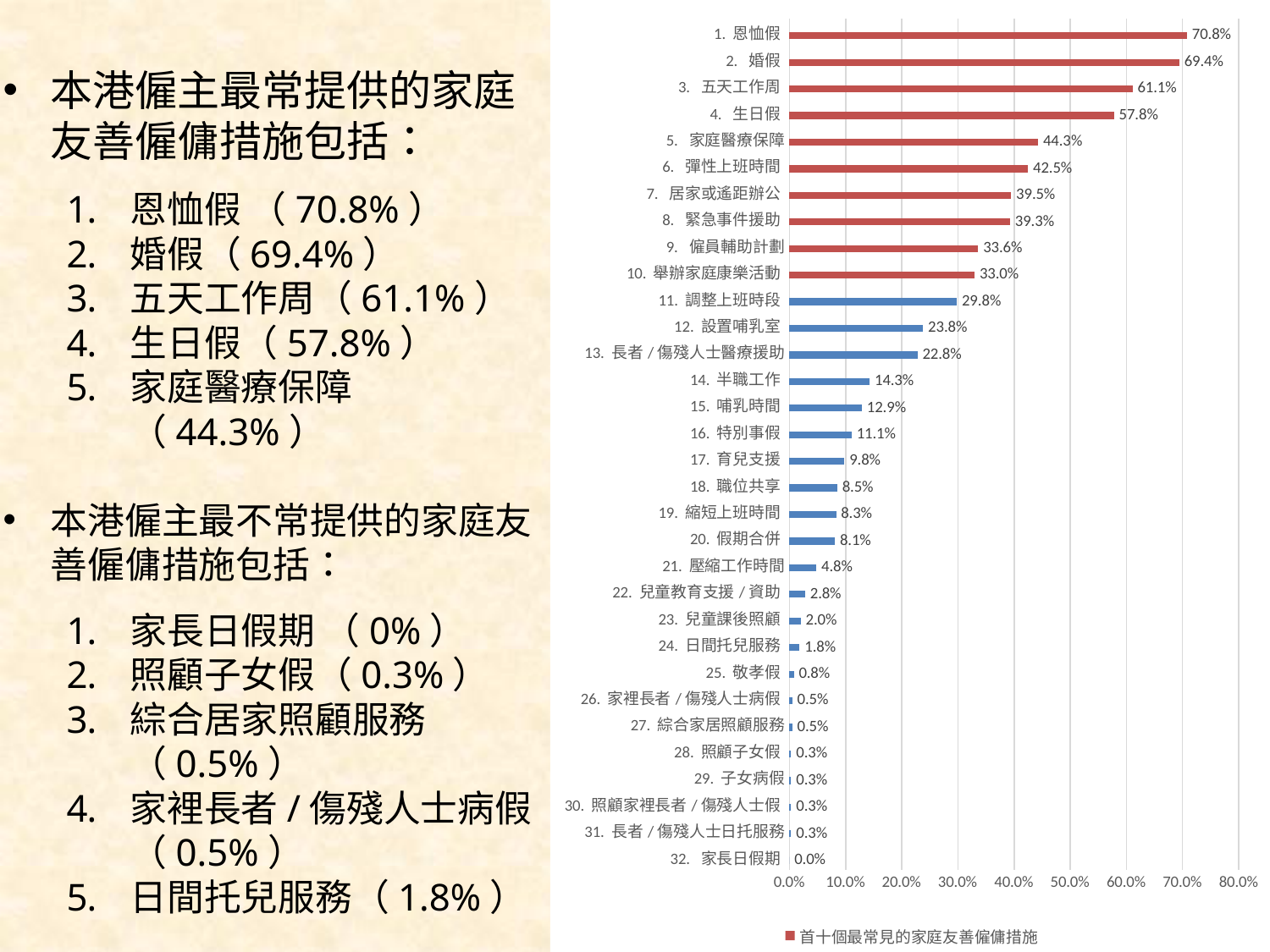
What is the value for 日間托兒服務? 1.8% What is the difference between the values for 恩恤假 and 婚假? 1.4% How many series does the legend list? 1 What is the value for 設置哺乳室? 23.8% What is the value for 恩恤假? 70.8% Which category has the highest value? 恩恤假 Is the value for 半職工作 greater or less than 20.0%? less Which has a larger value, 家庭醫療保障 or 彈性上班時間? 家庭醫療保障 What type of chart is shown on the slide? bar chart Which category has the lowest value? 家長日假期 What is the value for 家庭醫療保障? 44.3% How many categories are plotted in the chart? 32